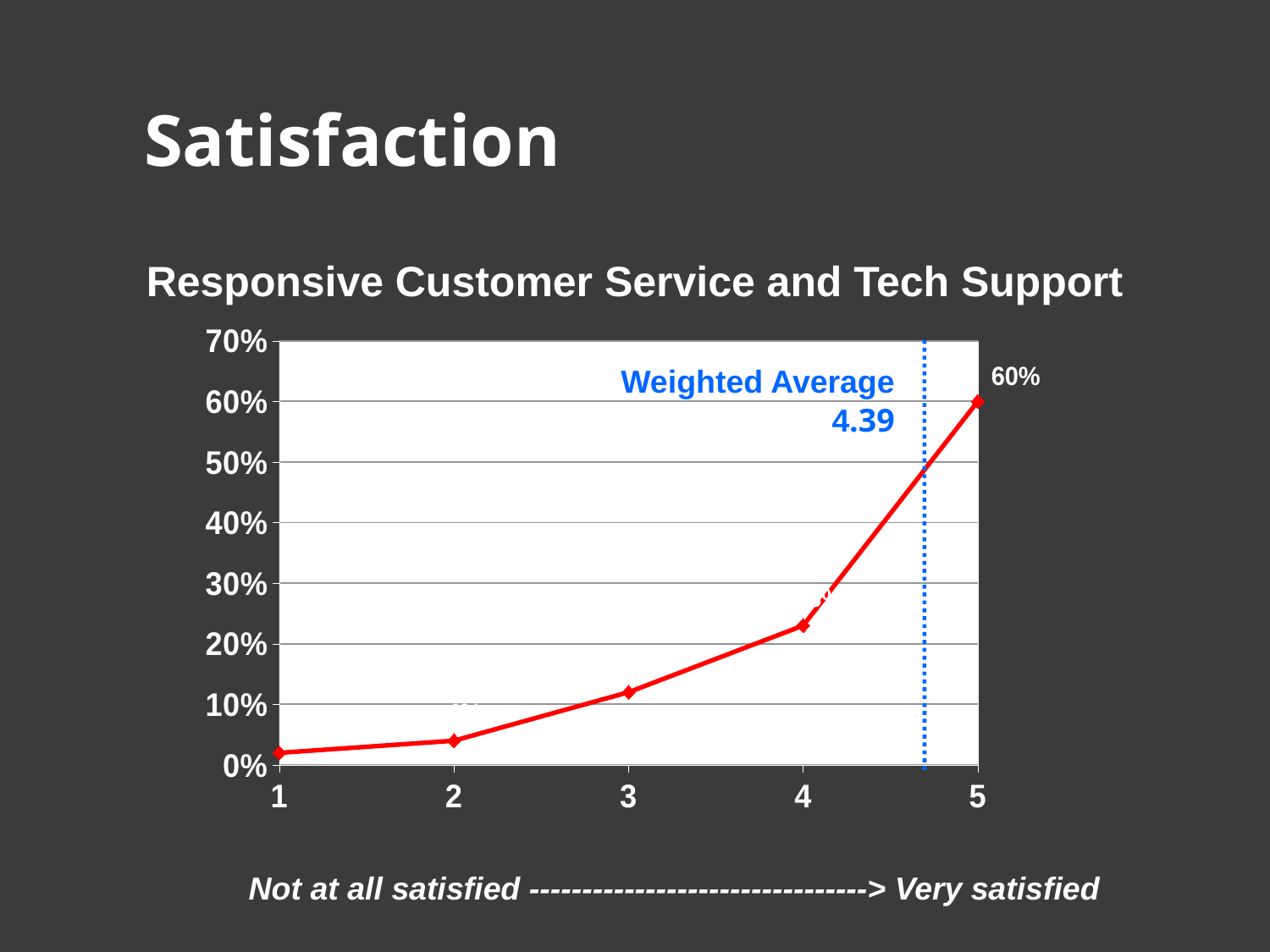
Is the value for rating 2 greater or less than 10%? less Which rating has the lowest value on the chart? 1 What kind of chart is shown on the slide? Line chart What is the title of the chart? Responsive Customer Service and Tech Support Is the value for rating 3 greater or less than 20%? less Is the value for rating 4 greater or less than 30%? less Which rating has the highest value on the chart? 5 Which has the larger value, rating 4 or rating 3? Rating 4 How many data points are plotted on the chart? 5 What is the value plotted for rating 5 on the Responsive Customer Service and Tech Support chart? 60% Do the values rise or fall as the rating increases from 1 to 5? Rise What weighted average is shown on the chart? 4.39